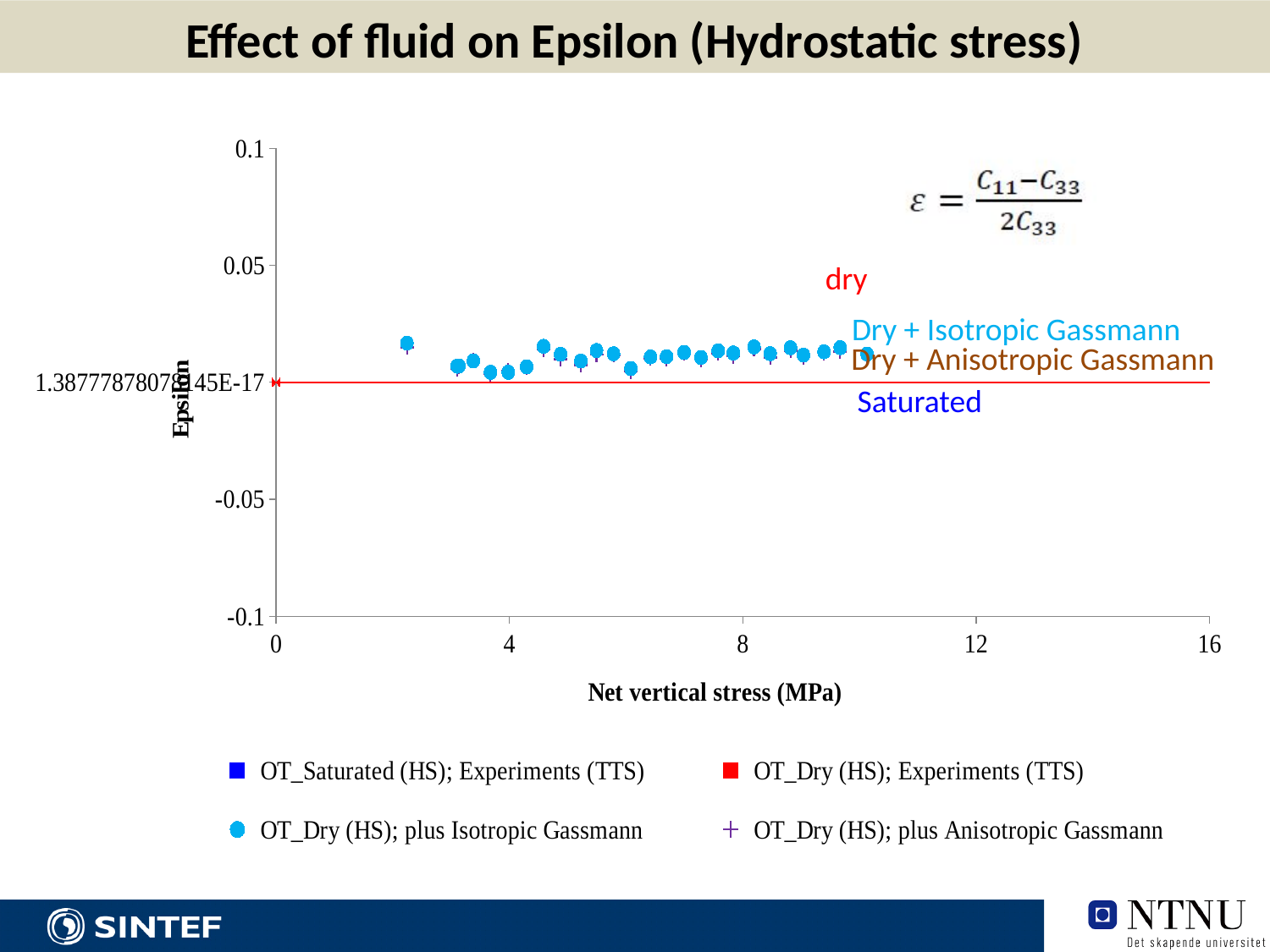
Are the values for OT_Dry (HS); plus Isotropic Gassmann greater or less than 0.05? less Are the values for OT_Dry (HS); plus Isotropic Gassmann greater or less than -0.05? greater Are the values for OT_Dry (HS); plus Anisotropic Gassmann greater or less than 0.05? less How many series does the legend list? 4 What is the title of the x axis? Net vertical stress (MPa) What kind of chart is shown on the slide? scatter chart